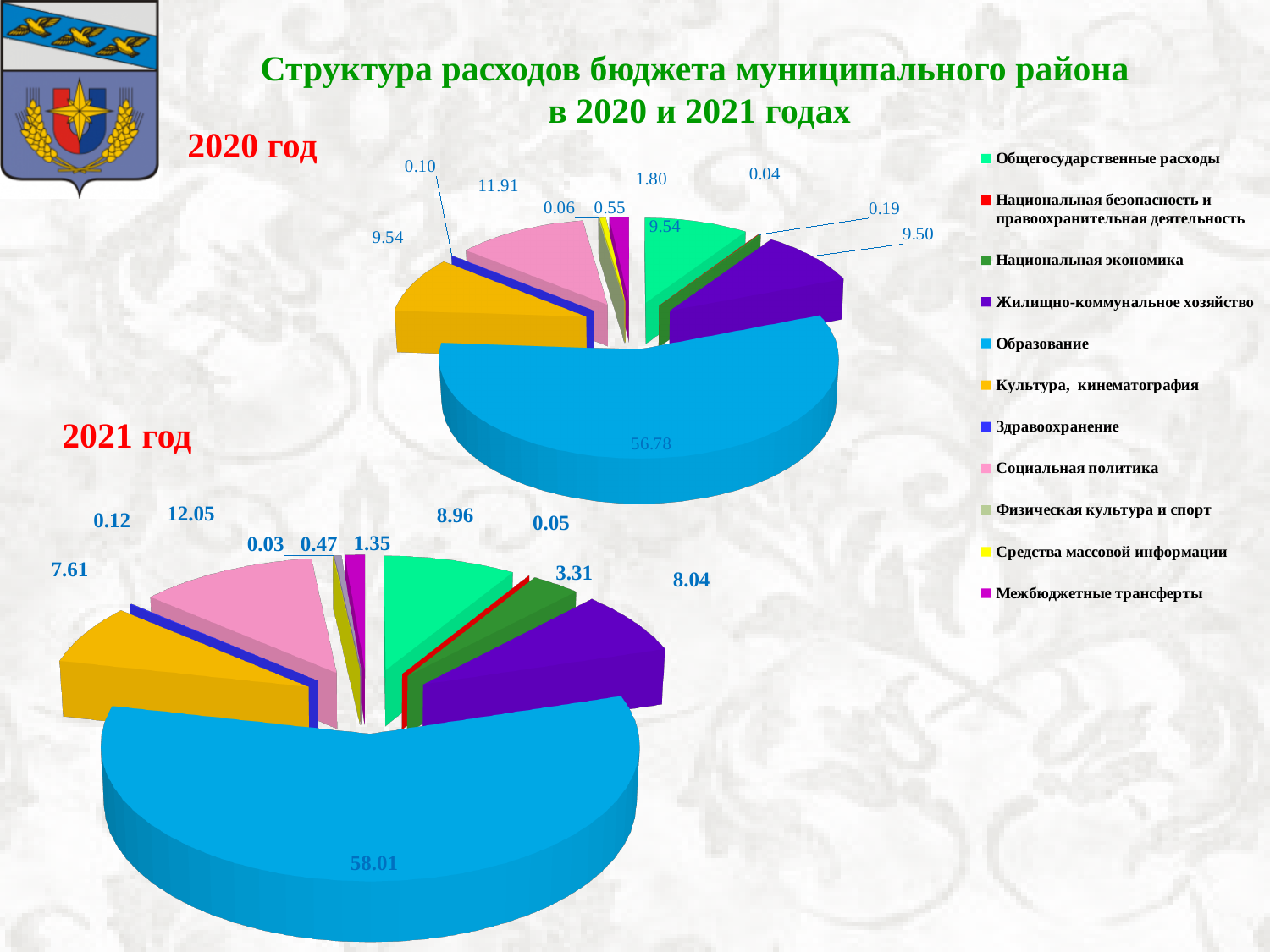
How many categories does the legend list? 11 On the 2021 pie chart, which is larger: Общегосударственные расходы or Культура, кинематография? Общегосударственные расходы On the 2020 pie chart, what is the value shown for Образование? 56.78 On the 2020 pie chart, what is the value shown for Социальная политика? 11.91 By how much did the value for Образование change from the 2020 chart to the 2021 chart? 1.23 What kind of chart is used to show the 2020 and 2021 budget structure? Pie chart On the 2021 pie chart, what is the value shown for Жилищно-коммунальное хозяйство? 8.04 Which colour represents Образование in the legend? Blue On the 2020 pie chart, which category has the largest share? Образование On the 2021 pie chart, which category has the largest share? Образование On the 2021 pie chart, what is the value shown for Социальная политика? 12.05 On the 2021 pie chart, what is the value shown for Образование? 58.01